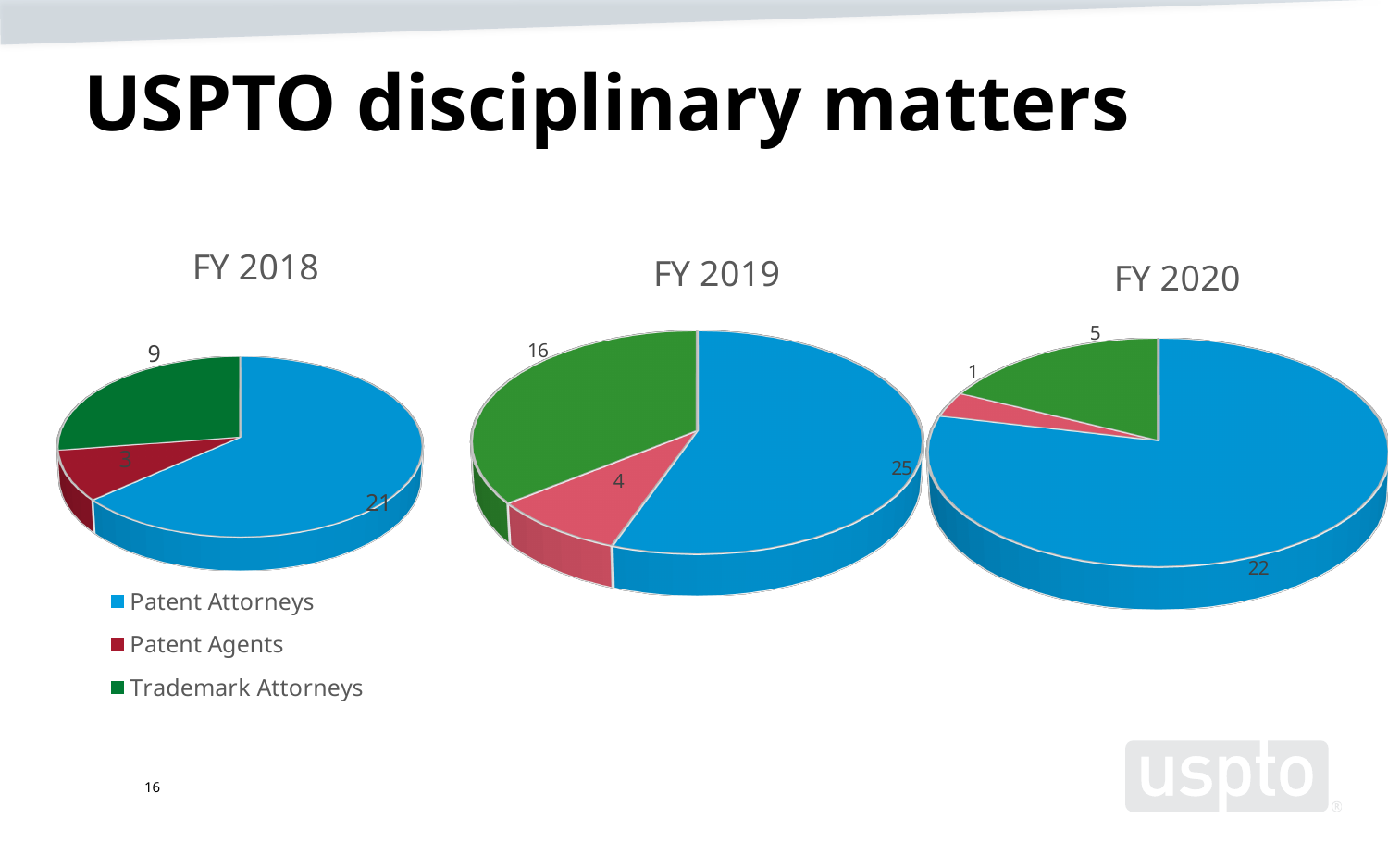
In the FY 2018 chart, what is the value for Patent Attorneys? 21 What kind of chart is used for FY 2019? Pie chart Which is larger: the Trademark Attorneys value in the FY 2018 chart or the Trademark Attorneys value in the FY 2020 chart? FY 2018 In the FY 2018 chart, which category has the smallest slice? Patent Agents Which category does the green colour represent in the legend? Trademark Attorneys In the FY 2020 chart, what is the value for Patent Agents? 1 In the FY 2019 chart, what is the difference between the Patent Attorneys value and the Trademark Attorneys value? 9 How many slices does the FY 2018 chart have? 3 What is the total of all slices in the FY 2019 chart? 45 In the FY 2020 chart, which category has the largest slice? Patent Attorneys In the FY 2020 chart, what is the difference between the Trademark Attorneys value and the Patent Agents value? 4 In the FY 2019 chart, what is the value for Trademark Attorneys? 16